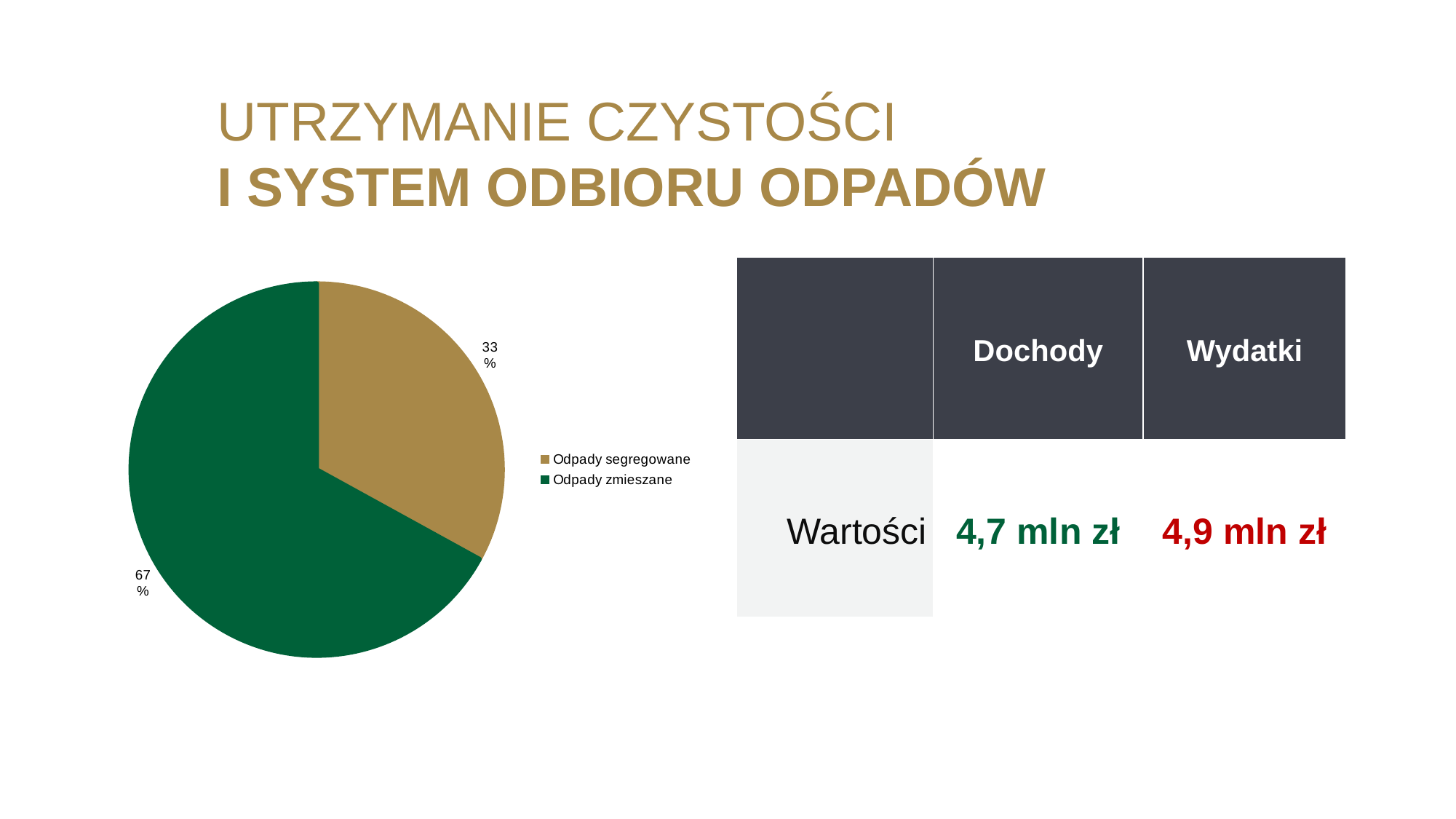
Which slice of the pie chart is the largest? Odpady zmieszane What kind of chart is shown on the slide? pie chart What colour is the Odpady zmieszane slice in the pie chart? green How many slices does the pie chart have? 2 What is the difference in percentage points between the Odpady zmieszane and Odpady segregowane slices? 34 Is the share for Odpady segregowane greater or less than 50%? less What share of the pie does Odpady segregowane have? 33% What share of the pie does Odpady zmieszane have? 67% Which is larger in the pie chart, Odpady segregowane or Odpady zmieszane? Odpady zmieszane What colour is the Odpady segregowane slice in the pie chart? gold Which slice of the pie chart is the smallest? Odpady segregowane How many entries does the pie chart's legend list? 2